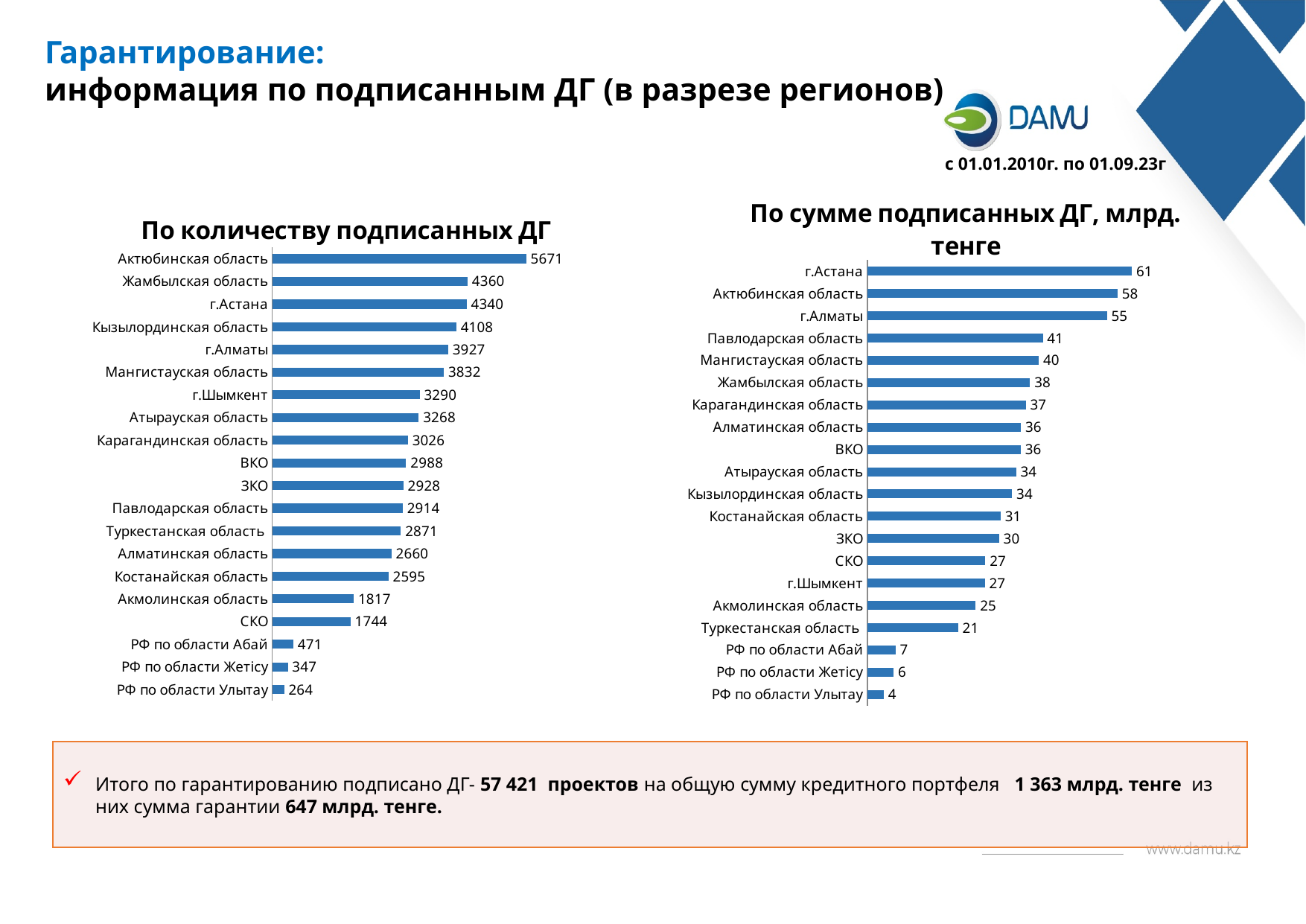
In the chart 'По количеству подписанных ДГ', how many regions are shown? 20 In the chart 'По количеству подписанных ДГ', what is the value for СКО? 1744 In the chart 'По количеству подписанных ДГ', what is the value for Кызылординская область? 4108 In the chart 'По сумме подписанных ДГ, млрд. тенге', which is larger: г.Алматы or Мангистауская область? г.Алматы In the chart 'По количеству подписанных ДГ', what is the difference between Актюбинская область and Жамбылская область? 1311 What type of chart is 'По количеству подписанных ДГ'? Bar chart In the chart 'По сумме подписанных ДГ, млрд. тенге', which region has the lowest value? РФ по области Улытау In the chart 'По количеству подписанных ДГ', which region has the highest value? Актюбинская область In the chart 'По сумме подписанных ДГ, млрд. тенге', what is the difference between г.Астана and Туркестанская область? 40 In the chart 'По сумме подписанных ДГ, млрд. тенге', what is the value for Павлодарская область? 41 In the chart 'По сумме подписанных ДГ, млрд. тенге', which region has the highest value? г.Астана In the chart 'По количеству подписанных ДГ', which region has the lowest value? РФ по области Улытау